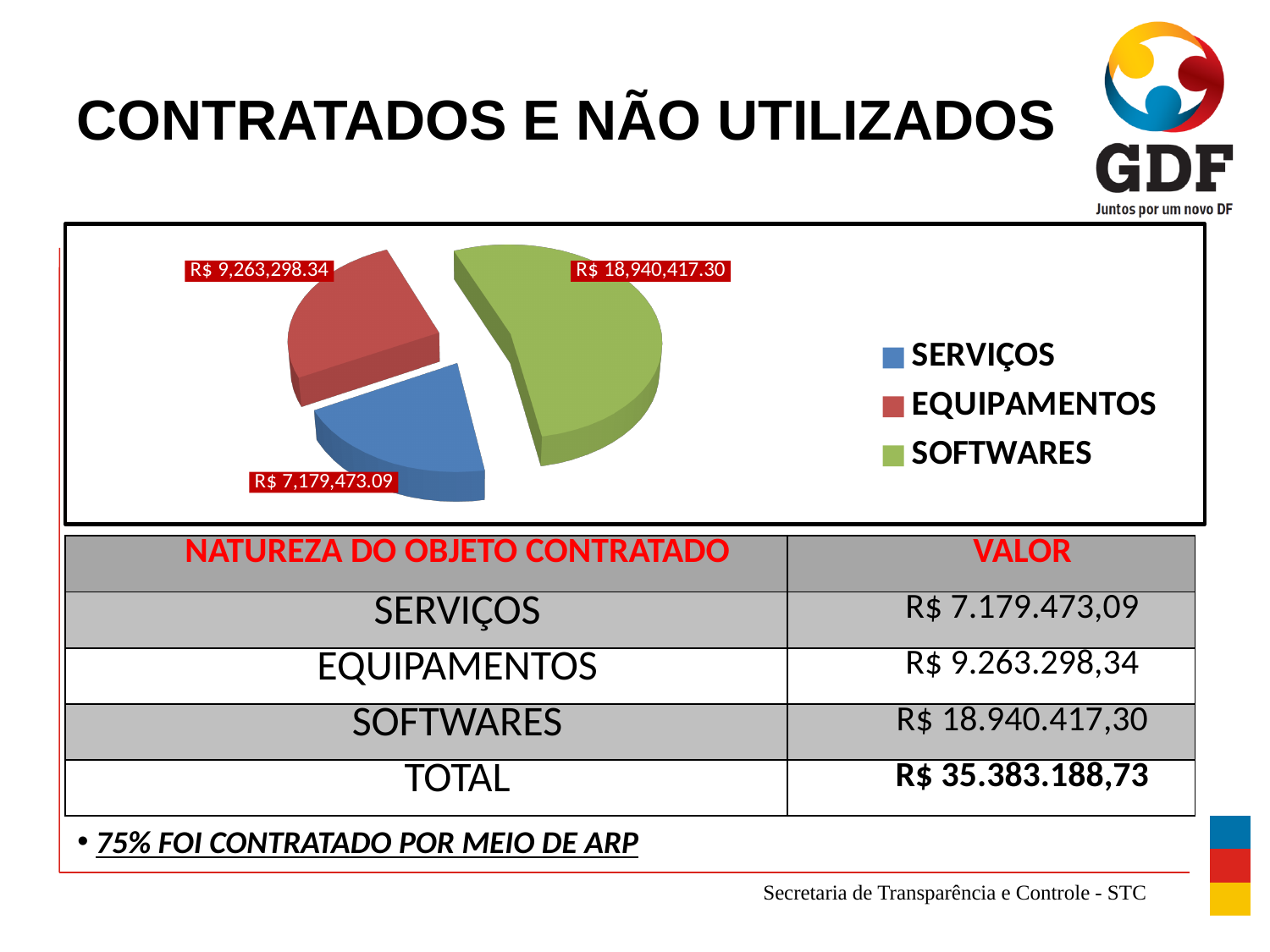
What is the difference between the SOFTWARES and EQUIPAMENTOS values in the pie chart? R$ 9,677,118.96 Which category has the smallest slice in the pie chart? SERVIÇOS Which is larger in the pie chart, EQUIPAMENTOS or SERVIÇOS? EQUIPAMENTOS Does the SOFTWARES slice account for more or less than half of the pie chart? more What value is labelled on the EQUIPAMENTOS slice of the pie chart? R$ 9,263,298.34 Which category has the largest slice in the pie chart? SOFTWARES What colour is the SOFTWARES slice in the pie chart? Green What type of chart is shown on the slide? Pie chart What value is labelled on the SOFTWARES slice of the pie chart? R$ 18,940,417.30 What value is labelled on the SERVIÇOS slice of the pie chart? R$ 7,179,473.09 How many slices does the pie chart have? 3 How many entries does the legend of the pie chart list? 3